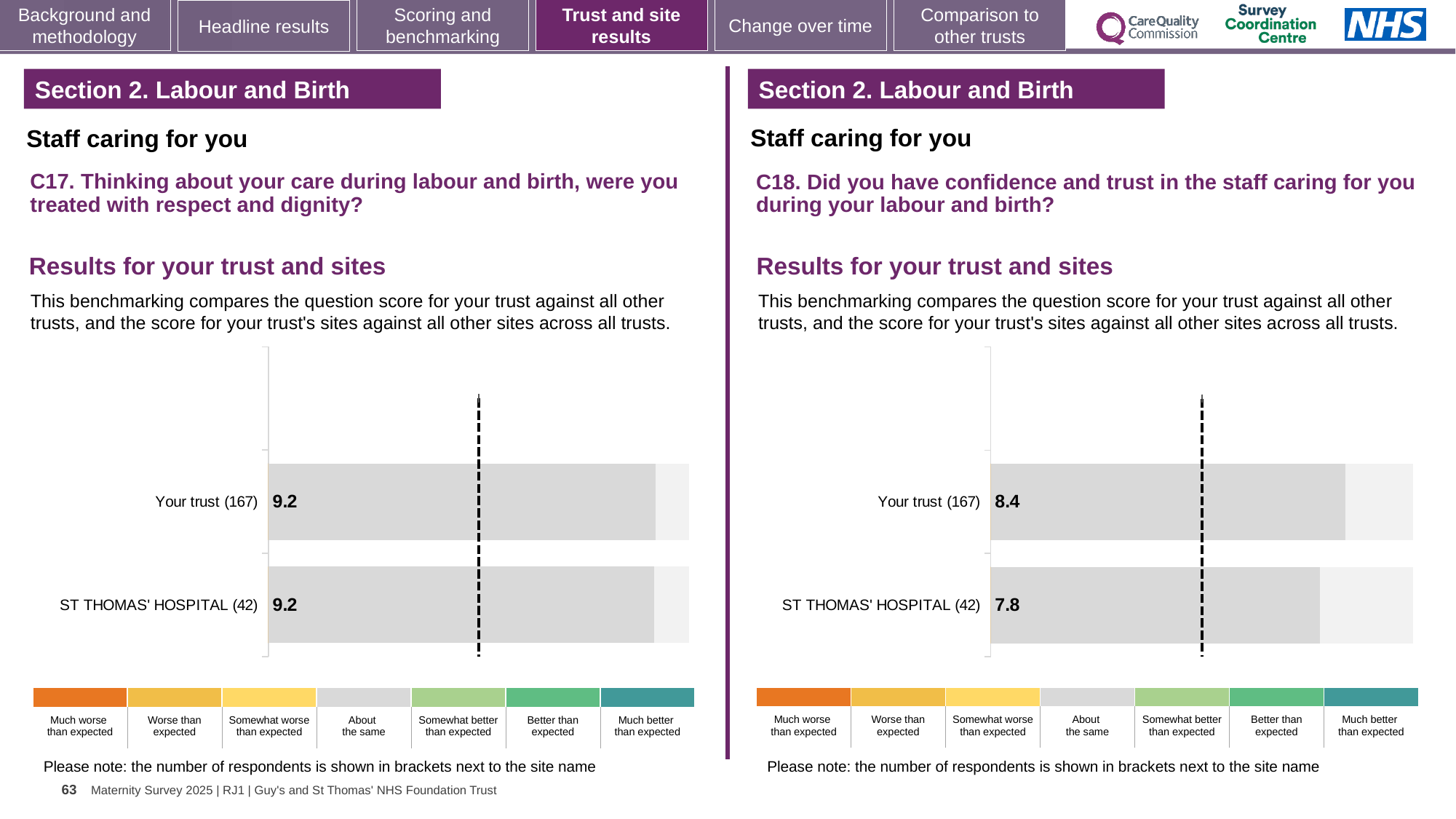
How many respondents are shown in brackets for ST THOMAS' HOSPITAL in the C17 chart on the left? 42 How many benchmark categories, from 'Much worse than expected' to 'Much better than expected', are shown in the colour key below the C18 chart on the right? 7 In the C18 chart on the right, what is the difference between the score for Your trust (167) and the score for ST THOMAS' HOSPITAL (42)? 0.6 In the C18 chart on the right, which category has the lowest score? ST THOMAS' HOSPITAL (42) In the C17 chart on the left, what is the difference between the score for Your trust (167) and the score for ST THOMAS' HOSPITAL (42)? 0 In the C17 chart on the left, what is the score for ST THOMAS' HOSPITAL (42)? 9.2 How many bars are plotted in the C17 chart on the left? 2 In the C18 chart on the right, what is the score for Your trust (167)? 8.4 In the C17 chart on the left, what is the score for Your trust (167)? 9.2 What kind of chart is used for the C18 results on the right? Bar chart In the C18 chart on the right, what is the score for ST THOMAS' HOSPITAL (42)? 7.8 In the C18 chart on the right, which has the higher score, Your trust (167) or ST THOMAS' HOSPITAL (42)? Your trust (167)